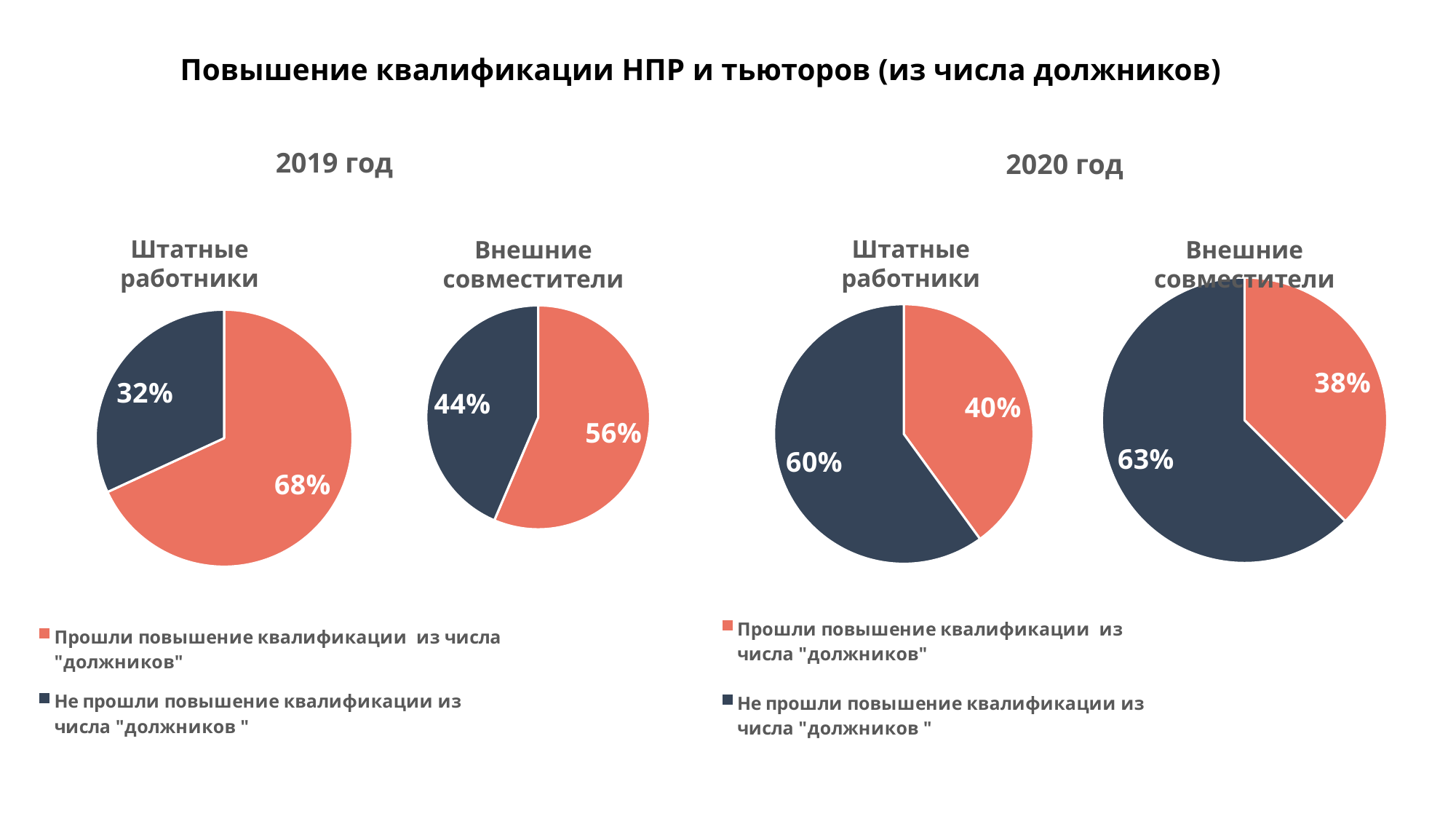
In the 2019 'Внешние совместители' pie chart, what share did not pass qualification improvement? 44% In the 2019 'Штатные работники' pie chart, what share did not pass qualification improvement? 32% What is the difference between the share of 'Штатные работники' who passed qualification improvement in 2019 and in 2020? 28% In the 2020 'Внешние совместители' pie chart, what share passed qualification improvement? 38% In the 2020 'Штатные работники' pie chart, which slice is larger: passed or did not pass qualification improvement? Did not pass (60%) How many entries does the legend under the 2019 charts list? 2 In the 2020 'Штатные работники' pie chart, what share passed qualification improvement? 40% What type of charts are shown on the slide? Pie charts In the 2019 'Внешние совместители' pie chart, what share passed qualification improvement? 56% In the 2019 'Штатные работники' pie chart, what share passed qualification improvement ('Прошли повышение квалификации из числа "должников"')? 68% How many pie charts are on the slide? 4 In the 2020 'Внешние совместители' pie chart, what share did not pass qualification improvement? 63%